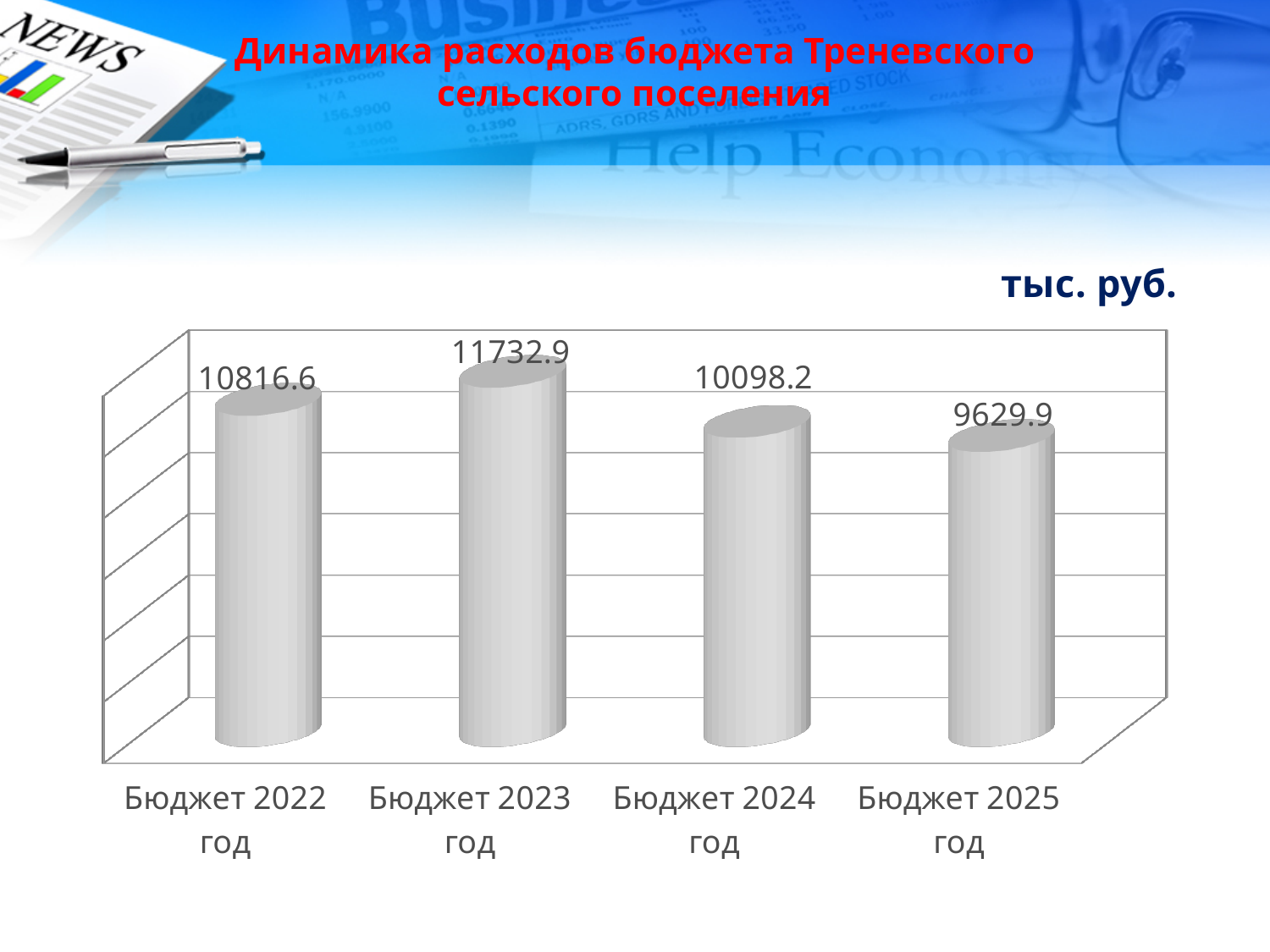
What is the value for Бюджет 2023 год? 11732.9 Which category has the highest value? Бюджет 2023 год What kind of chart is shown on the slide? Bar chart What is the difference between the values for Бюджет 2023 год and Бюджет 2022 год? 916.3 What is the difference between the values for Бюджет 2023 год and Бюджет 2025 год? 2103.0 What is the value for Бюджет 2022 год? 10816.6 Do the values rise or fall from Бюджет 2023 год to Бюджет 2025 год? Fall Which is larger, the value for Бюджет 2022 год or the value for Бюджет 2024 год? Бюджет 2022 год What is the value for Бюджет 2025 год? 9629.9 Which category has the lowest value? Бюджет 2025 год What is the value for Бюджет 2024 год? 10098.2 How many categories are shown on the chart? 4